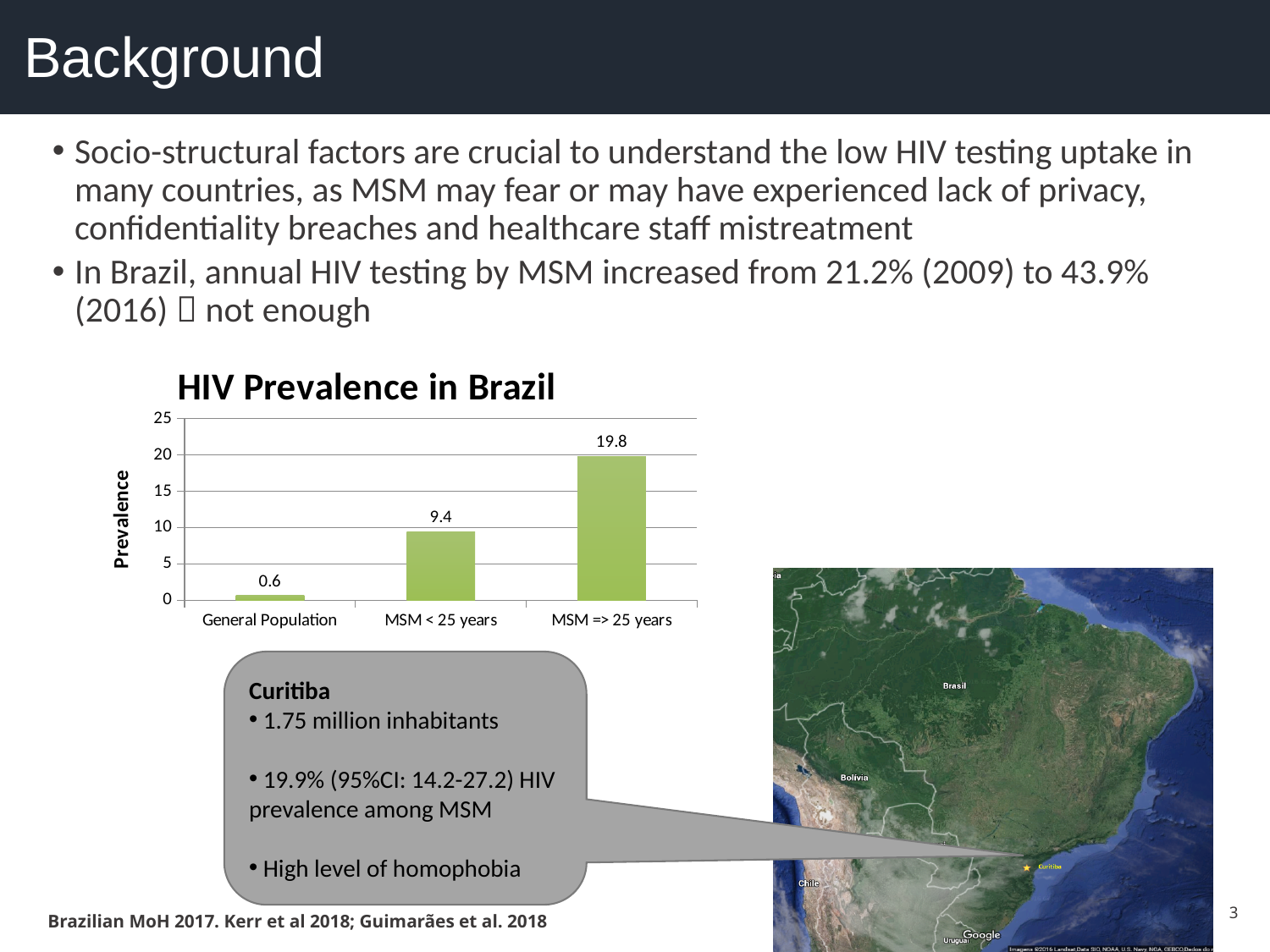
What is the HIV prevalence value shown for MSM < 25 years? 9.4 What is the HIV prevalence value shown for the General Population? 0.6 What is the title of the chart on the slide? HIV Prevalence in Brazil What type of chart is used to show HIV prevalence in Brazil? Bar chart Which has a higher HIV prevalence, MSM < 25 years or the General Population? MSM < 25 years Which category has the lowest HIV prevalence in the chart? General Population What is the difference in prevalence between MSM < 25 years and the General Population? 8.8 How many categories are shown on the x axis of the chart? 3 What is the difference in prevalence between MSM => 25 years and MSM < 25 years? 10.4 Which category has the highest HIV prevalence in the chart? MSM => 25 years What is the HIV prevalence value shown for MSM => 25 years? 19.8 Is the value for MSM => 25 years greater or less than 15? greater